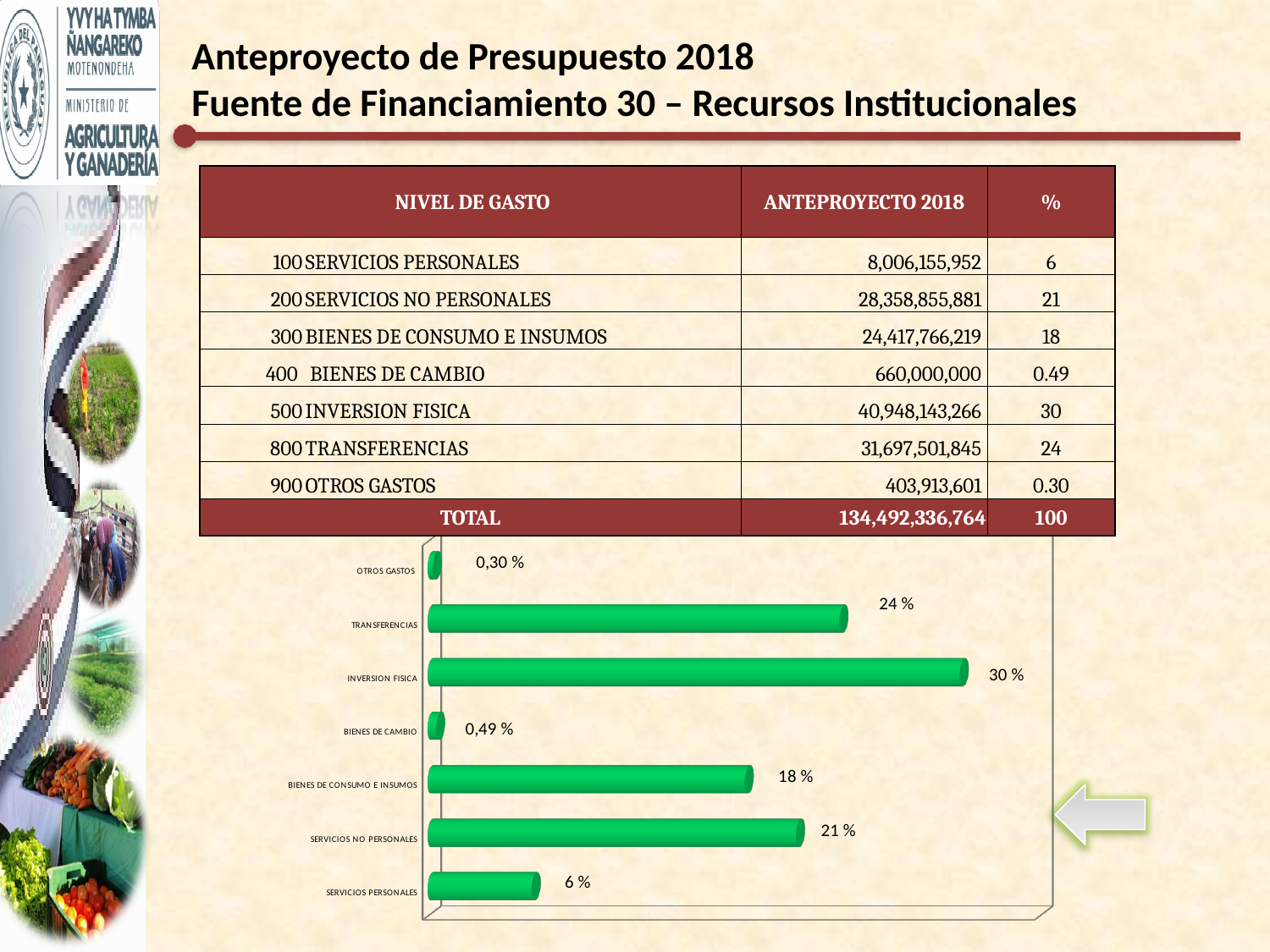
What colour are the bars in the chart? green What is the value shown for TRANSFERENCIAS in the bar chart? 24 % How many categories does the bar chart show? 7 What is the value shown for BIENES DE CAMBIO in the bar chart? 0,49 % Which category has the lowest value in the bar chart? OTROS GASTOS What is the value shown for OTROS GASTOS in the bar chart? 0,30 % What is the value shown for INVERSION FISICA in the bar chart? 30 % What is the difference between the values for INVERSION FISICA and TRANSFERENCIAS in the bar chart? 6 % Which is larger in the bar chart, SERVICIOS NO PERSONALES or BIENES DE CONSUMO E INSUMOS? SERVICIOS NO PERSONALES Which category has the highest value in the bar chart? INVERSION FISICA What kind of chart is shown on the slide? bar chart What is the value shown for SERVICIOS PERSONALES in the bar chart? 6 %